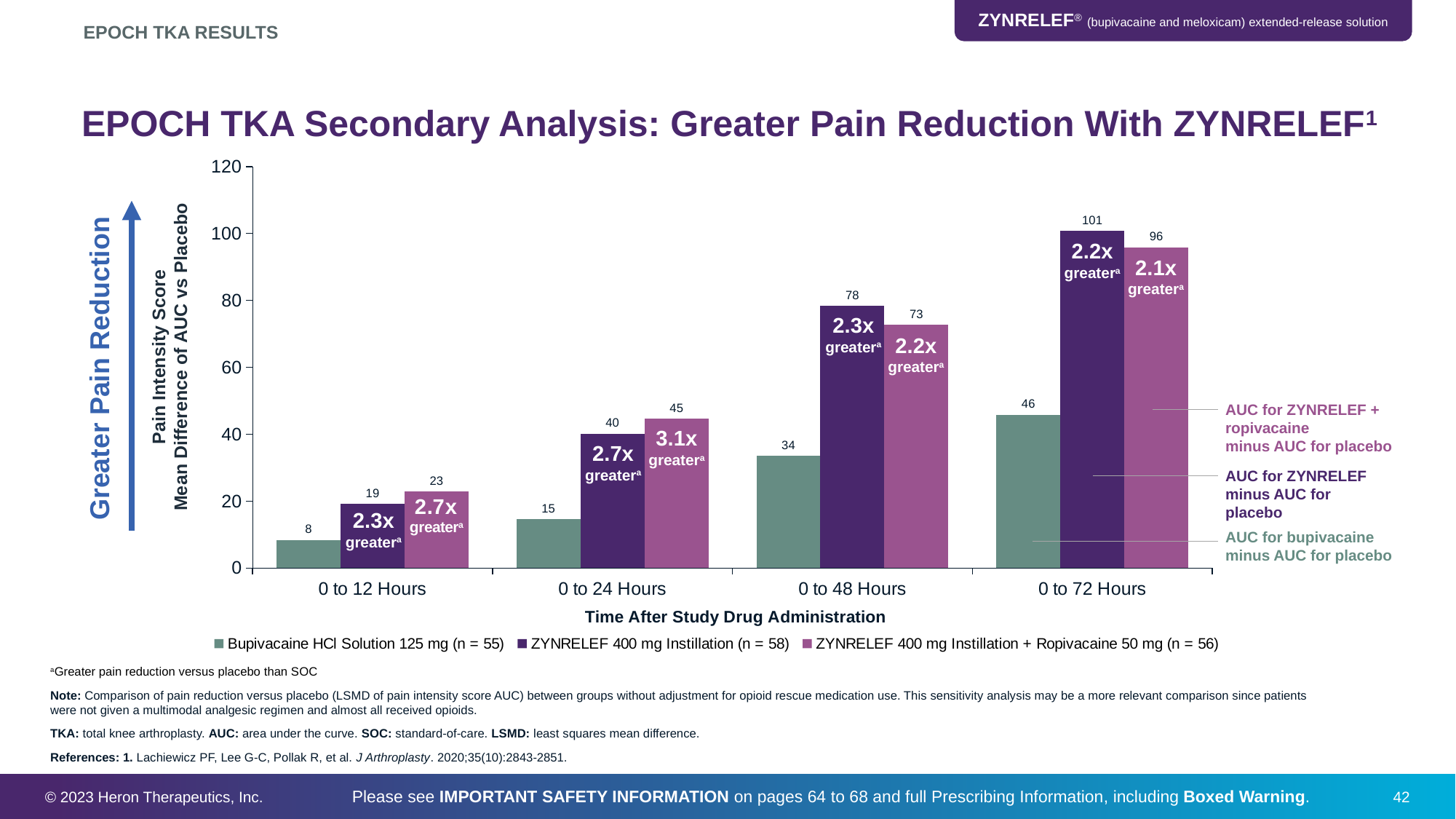
What kind of chart is shown on the slide? Bar chart What is the title of the x axis? Time After Study Drug Administration What is the value for Bupivacaine HCl Solution 125 mg (n = 55) at 0 to 12 Hours? 8 What is the difference between the ZYNRELEF 400 mg Instillation (n = 58) value and the Bupivacaine HCl Solution 125 mg (n = 55) value at 0 to 48 Hours? 44 How many time intervals are shown on the x axis? 4 Which time interval has the lowest value for ZYNRELEF 400 mg Instillation (n = 58)? 0 to 12 Hours Do the values for Bupivacaine HCl Solution 125 mg (n = 55) rise or fall from 0 to 12 Hours to 0 to 72 Hours? Rise What is the value for ZYNRELEF 400 mg Instillation + Ropivacaine 50 mg (n = 56) at 0 to 24 Hours? 45 What is the value for ZYNRELEF 400 mg Instillation (n = 58) at 0 to 72 Hours? 101 Which time interval has the highest value for Bupivacaine HCl Solution 125 mg (n = 55)? 0 to 72 Hours How many series does the legend list? 3 At 0 to 72 Hours, which is larger: the value for ZYNRELEF 400 mg Instillation (n = 58) or the value for ZYNRELEF 400 mg Instillation + Ropivacaine 50 mg (n = 56)? ZYNRELEF 400 mg Instillation (n = 58)